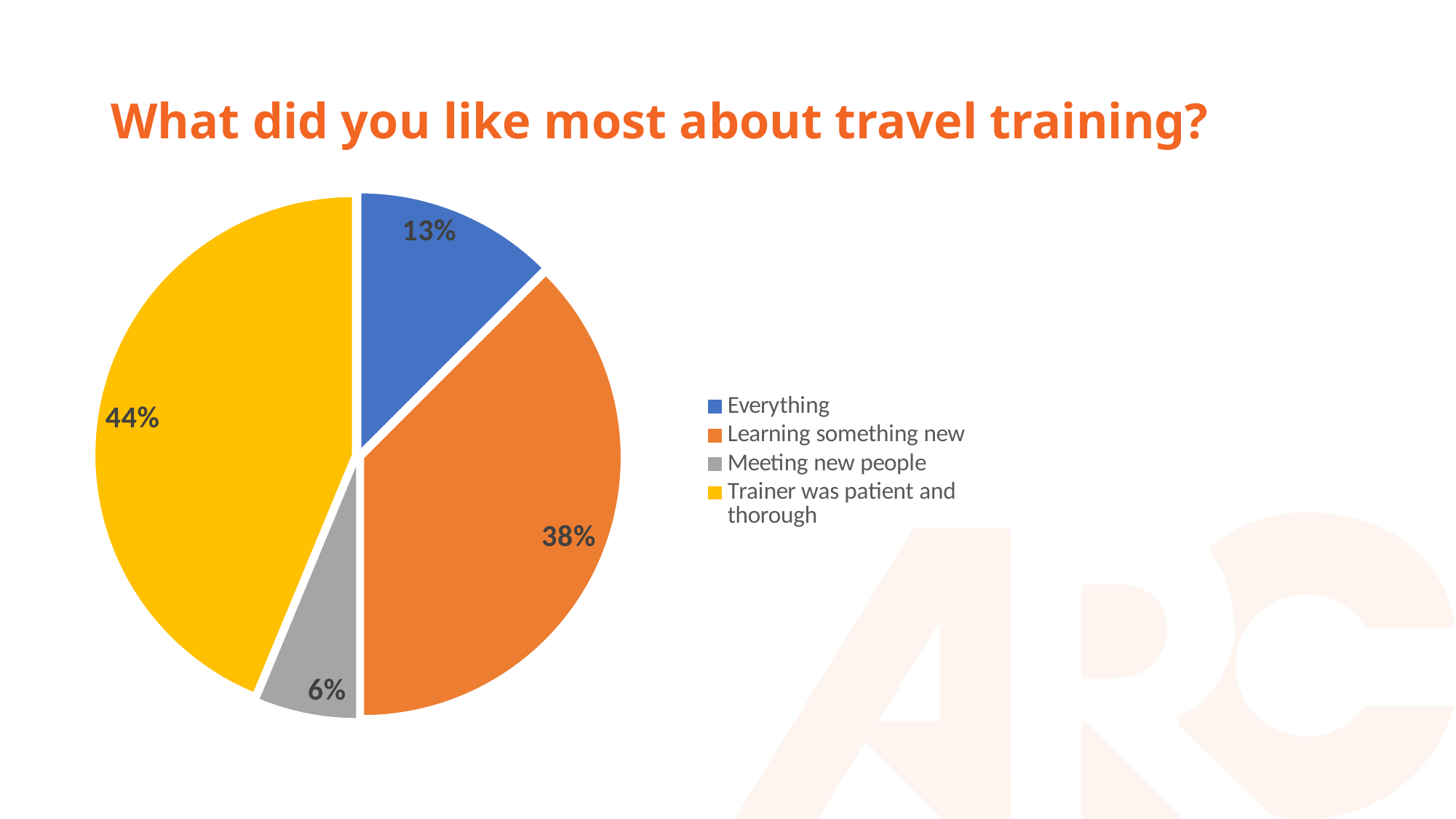
What kind of chart is shown on the slide? pie chart What colour is the slice for 'Learning something new'? orange What is the title of the slide? What did you like most about travel training? What share of the pie is labelled for 'Learning something new'? 38% What is the difference in percentage points between 'Trainer was patient and thorough' and 'Learning something new'? 6 Which category has the smallest slice of the pie? Meeting new people What share of the pie is labelled for 'Everything'? 13% How many slices does the pie chart have? 4 Which category has the largest slice of the pie? Trainer was patient and thorough What share of the pie is labelled for 'Meeting new people'? 6% Which is larger: the slice for 'Everything' or the slice for 'Meeting new people'? Everything